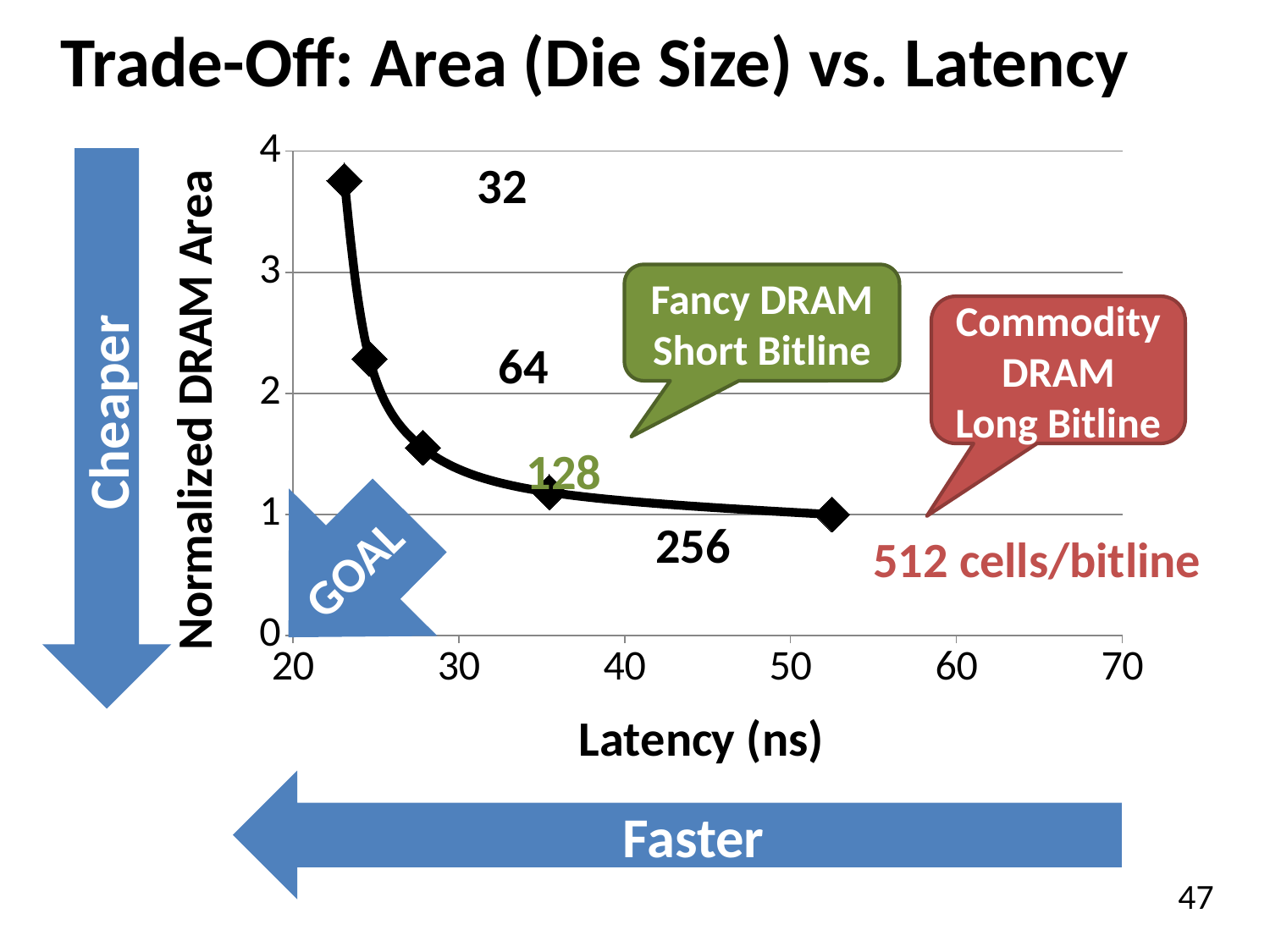
Is the normalized DRAM area for the 64 cells/bitline point greater or less than 2? greater What kind of chart is shown on the slide? line chart Is the normalized DRAM area for the 32 cells/bitline point greater or less than 3? greater Is the latency for the 256 cells/bitline point greater or less than 40 ns? less How many data points are plotted on the chart? 5 Which point has the lowest normalized DRAM area? 512 cells/bitline As latency increases along the x axis, does the normalized DRAM area rise or fall? fall Which has the larger normalized DRAM area, the 64 point or the 256 point? 64 What is the title of the x axis? Latency (ns) Which point has the highest normalized DRAM area? 32 Which data point does the 'Commodity DRAM Long Bitline' callout point to? 512 cells/bitline